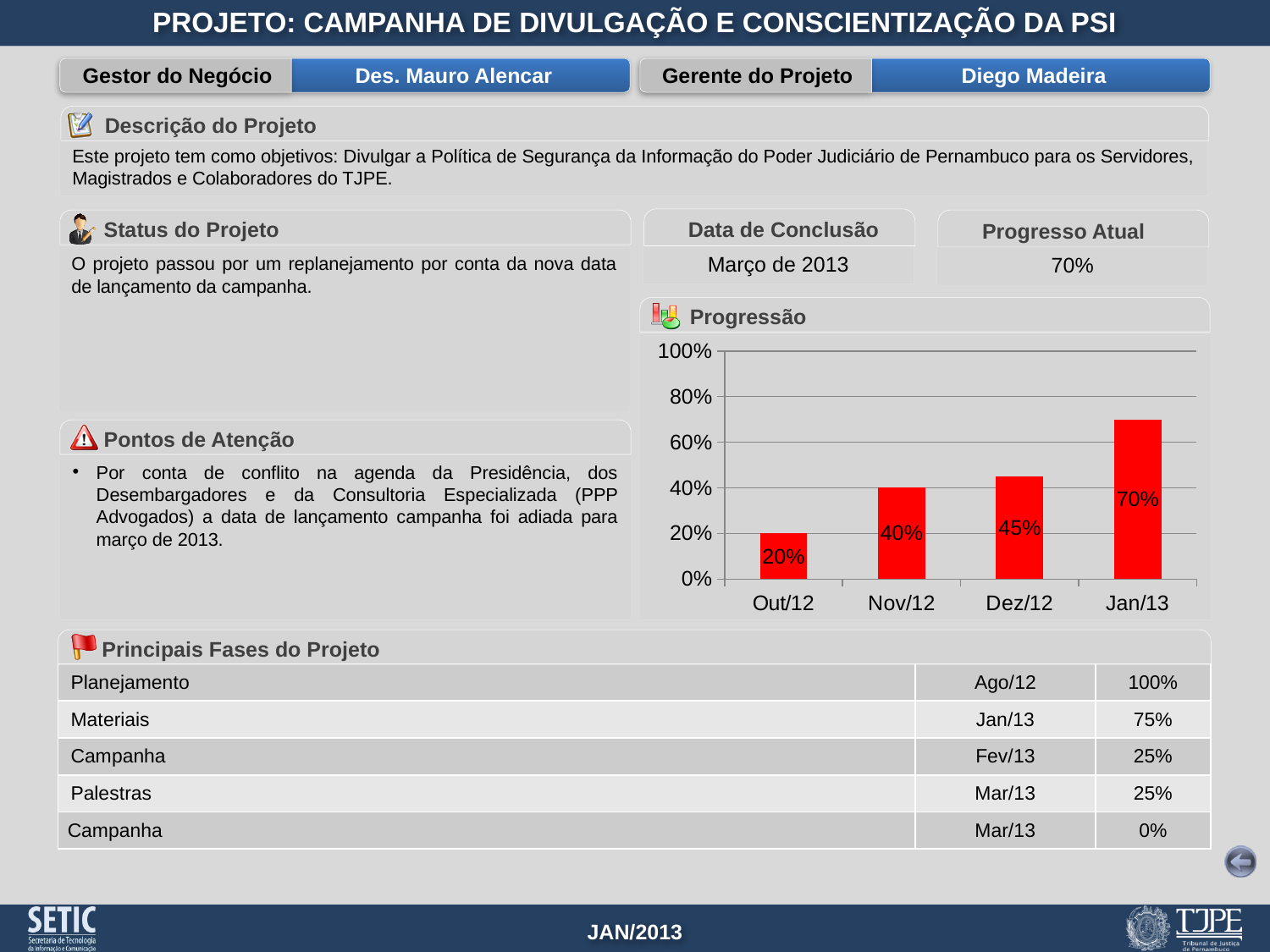
How many months are plotted in the Progressão chart? 4 What kind of chart is the Progressão chart? Bar chart What is the difference between the values for Jan/13 and Dez/12 in the Progressão chart? 25% What is the difference between the values for Nov/12 and Out/12 in the Progressão chart? 20% What is the value for Dez/12 in the Progressão chart? 45% What is the value for Nov/12 in the Progressão chart? 40% Which month has the lowest value in the Progressão chart? Out/12 Which month has the highest value in the Progressão chart? Jan/13 What is the value for Out/12 in the Progressão chart? 20% What is the value for Jan/13 in the Progressão chart? 70% Do the values in the Progressão chart rise or fall from Out/12 to Jan/13? Rise Which is larger in the Progressão chart, the value for Nov/12 or the value for Dez/12? Dez/12